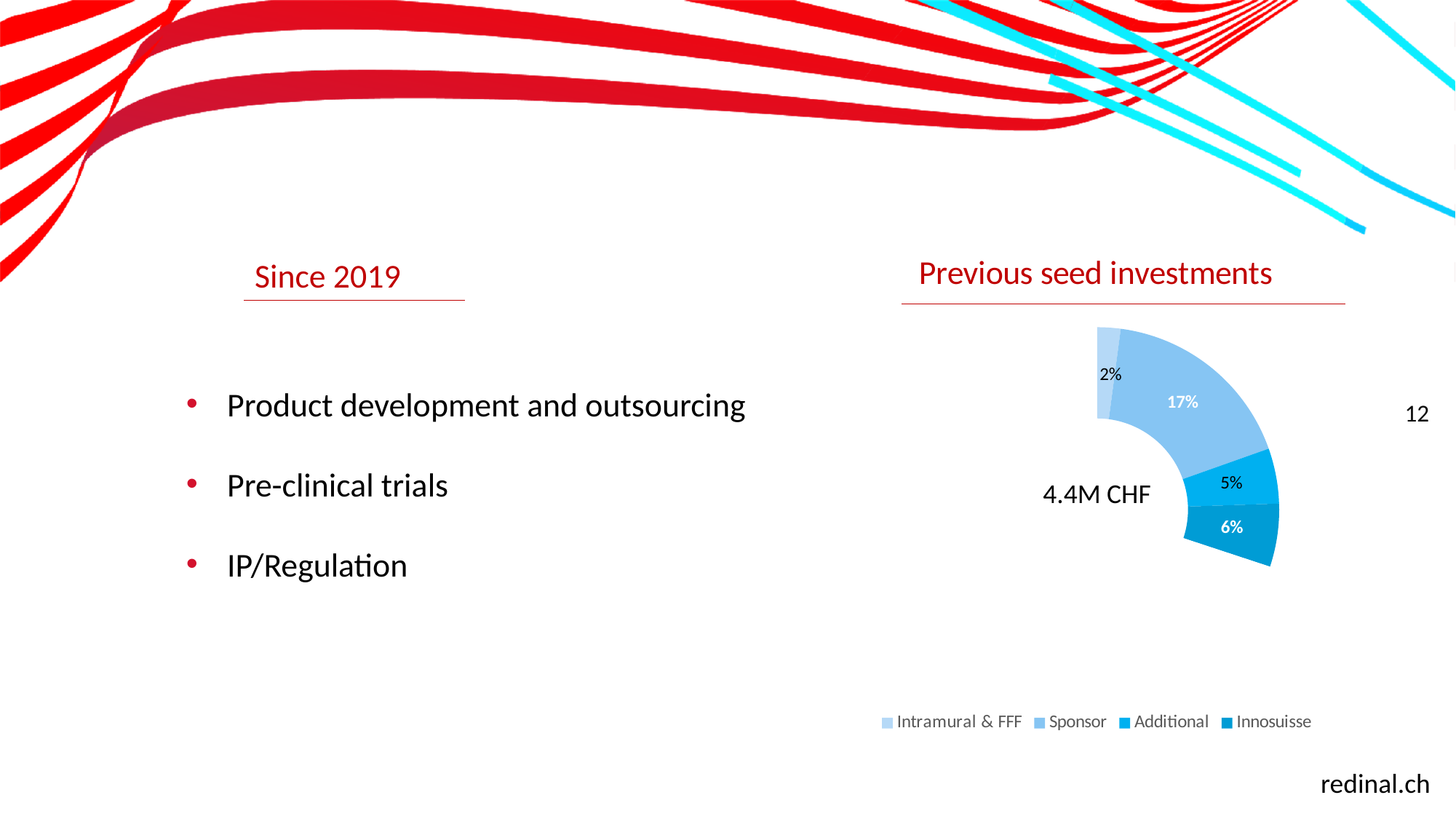
What percentage is shown for Additional in the 'Previous seed investments' chart? 5% How many entries does the legend of the 'Previous seed investments' chart list? 4 What is the title of the chart on the slide? Previous seed investments In the 'Previous seed investments' chart, what is the difference between the Sponsor and Innosuisse percentages? 11% What amount is written next to the 'Previous seed investments' chart? 4.4M CHF What percentage is shown for Intramural & FFF in the 'Previous seed investments' chart? 2% In the 'Previous seed investments' chart, which is larger: Additional or Innosuisse? Innosuisse Which category has the largest share in the 'Previous seed investments' chart? Sponsor What percentage is shown for Innosuisse in the 'Previous seed investments' chart? 6% What kind of chart is shown under 'Previous seed investments'? doughnut chart What percentage is shown for Sponsor in the 'Previous seed investments' chart? 17% Which category has the smallest share in the 'Previous seed investments' chart? Intramural & FFF